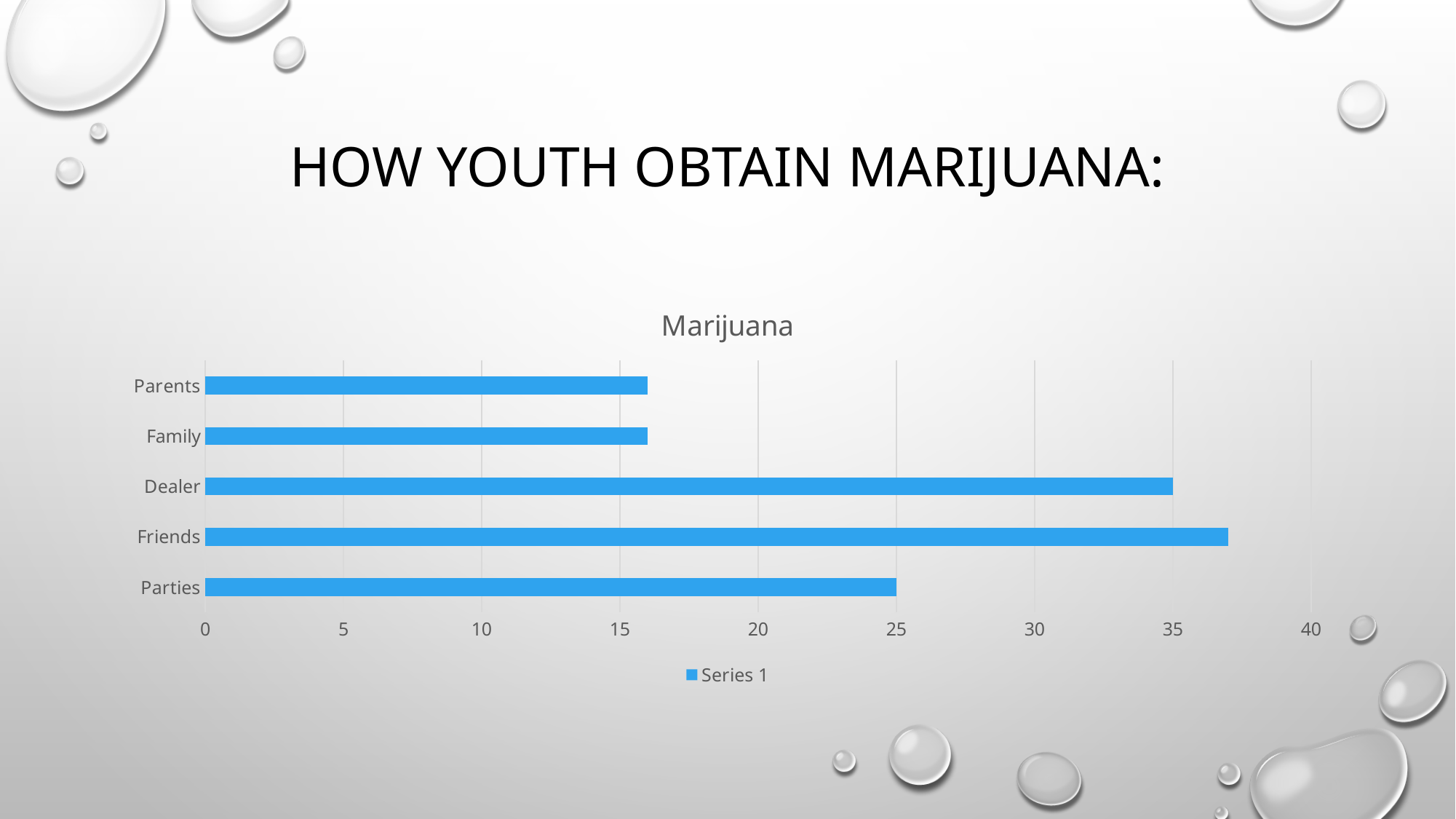
Is the value for Parents greater or less than 15? greater Is the value for Family greater or less than 20? less Which is larger, the value for Friends or the value for Dealer? Friends What type of chart is shown on the slide? bar chart What is the value for Parties? 25 Which category has the highest value? Friends What is the value for Dealer? 35 How many series does the legend list? 1 What is the difference between the values for Dealer and Parties? 10 How many categories are plotted in the chart? 5 What is the title of the chart? Marijuana Which is larger, the value for Parties or the value for Parents? Parties